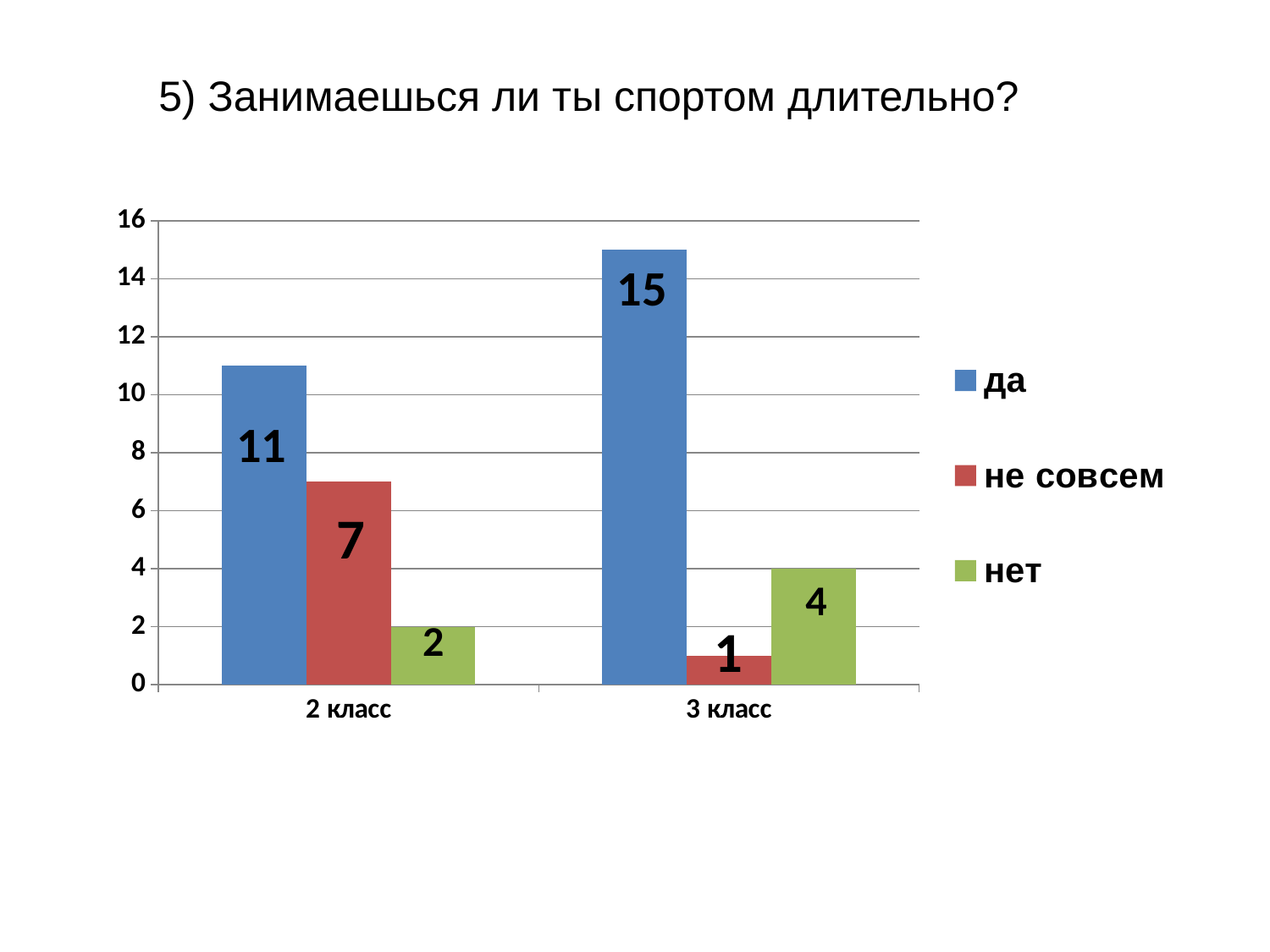
What is the value for "да" in "2 класс"? 11 What is the difference between the "да" values for "3 класс" and "2 класс"? 4 Is the value for "да" in "3 класс" greater or less than 14? greater Which series has the lowest value in "2 класс"? нет How many categories are shown on the x axis? 2 Which series has the highest value in "3 класс"? да What is the value for "не совсем" in "3 класс"? 1 What kind of chart is shown on the slide? bar chart What colour represents the "нет" series? green How many series does the legend list? 3 Which is larger: "не совсем" in "2 класс" or "нет" in "3 класс"? не совсем in 2 класс What is the value for "нет" in "3 класс"? 4